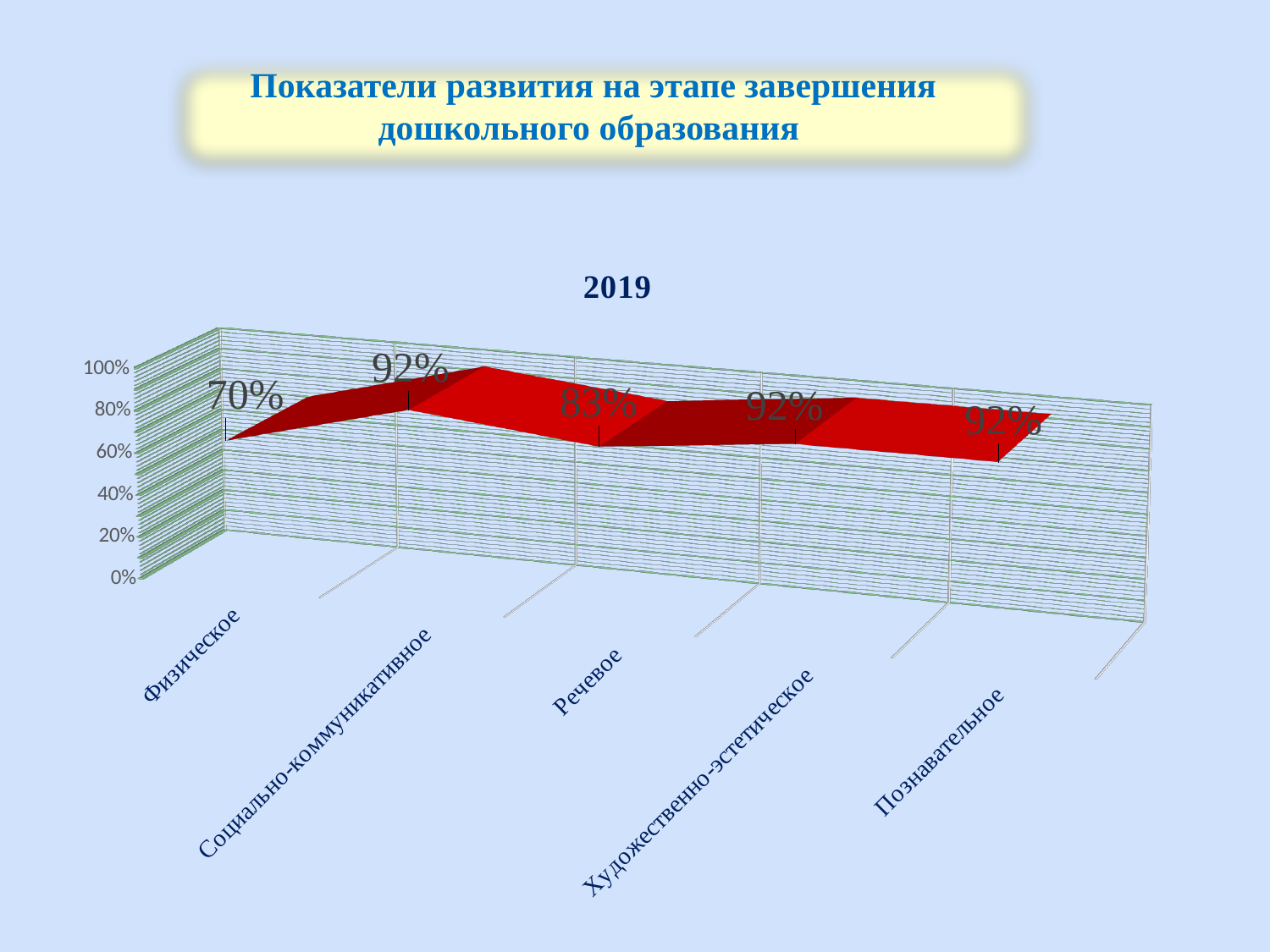
What is the difference between the values for Социально-коммуникативное and Речевое? 9% What kind of chart is this? line chart What is the value for Социально-коммуникативное? 92% Which is larger, the value for Художественно-эстетическое or the value for Речевое? Художественно-эстетическое What is the value for Познавательное? 92% What is the value for Речевое? 83% Which category has the lowest value? Физическое How many categories are shown on the x axis? 5 How many categories have a value of 92%? 3 What is the title of the chart? 2019 What is the difference between the values for Речевое and Физическое? 13% What is the value for Физическое? 70%